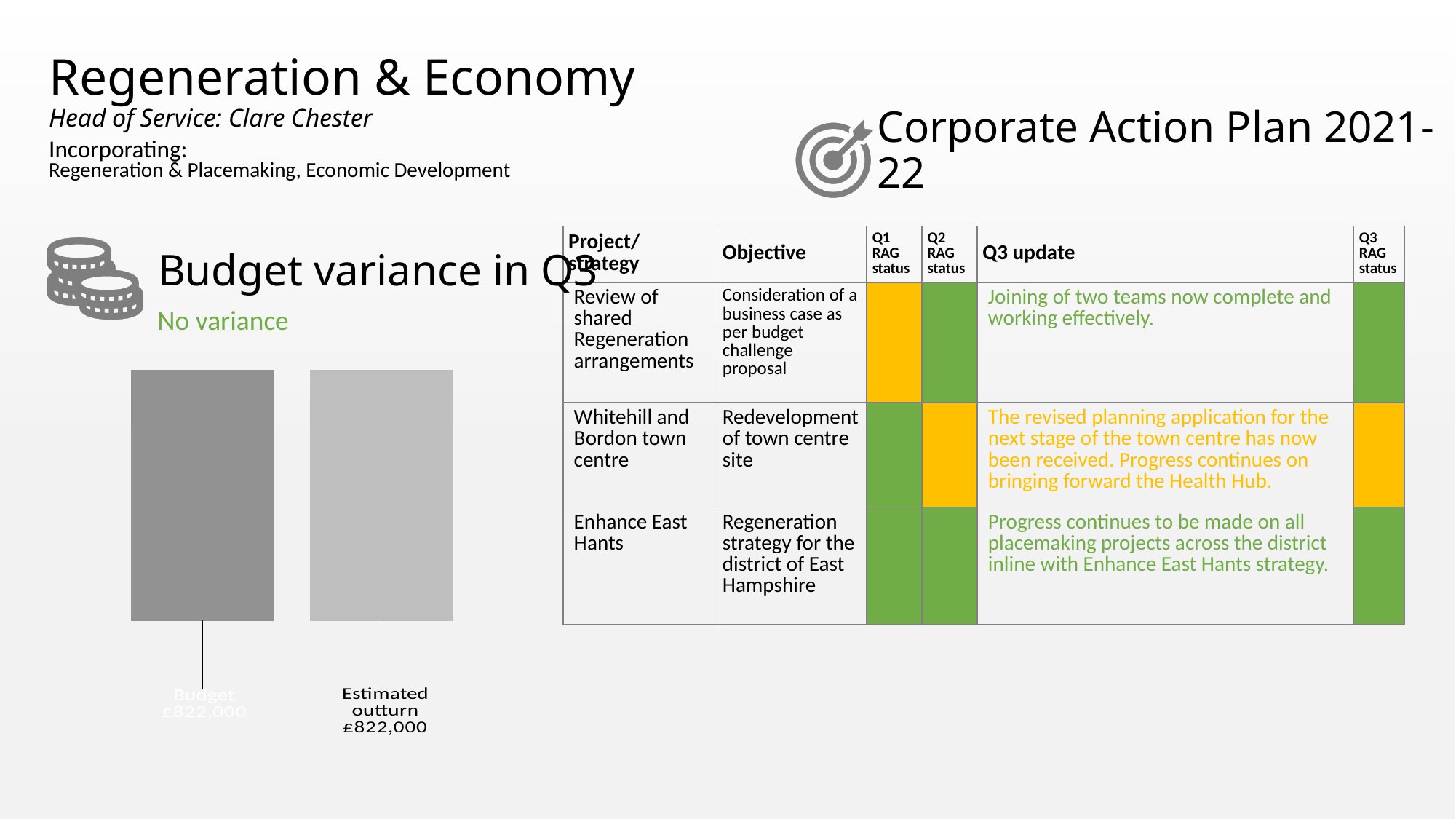
What is the difference between the Budget and Estimated outturn values in the Budget variance in Q3 chart? £0 What is the title of the chart on the left of the slide? Budget variance in Q3 How many bars are shown in the Budget variance in Q3 chart? 2 What is the value of the Estimated outturn bar in the Budget variance in Q3 chart? £822,000 Are the Budget and Estimated outturn values in the Budget variance in Q3 chart equal? Yes What kind of chart is used to show the budget variance in Q3? Bar chart What does the text below the Budget variance in Q3 chart title say about the variance? No variance What is the value of the Budget bar in the Budget variance in Q3 chart? £822,000